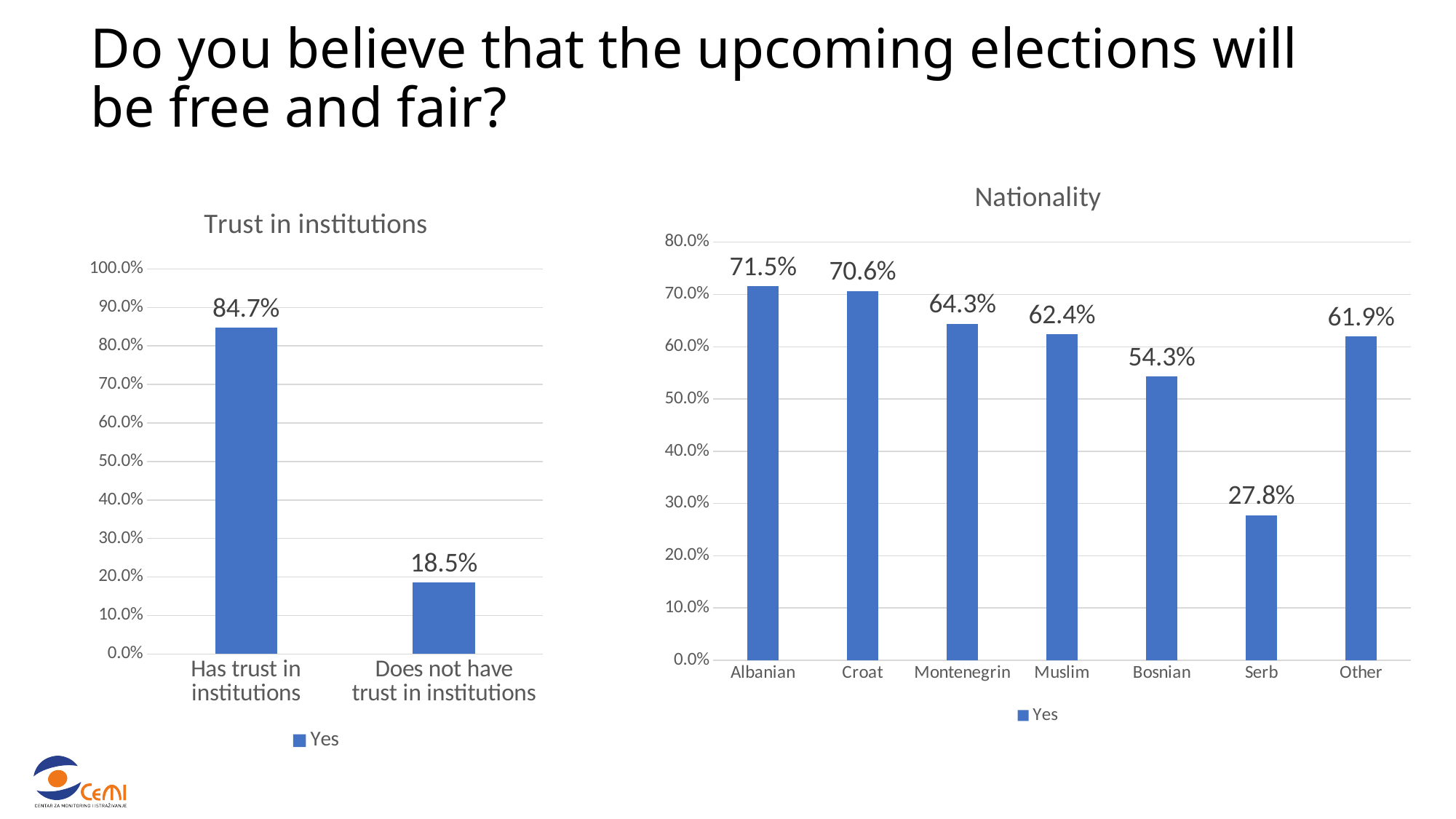
In the 'Trust in institutions' chart, what is the difference between the two bars? 66.2% In the 'Nationality' chart, which nationality has the lowest value? Serb In the 'Nationality' chart, which is larger, the value for Muslim or the value for Other? Muslim In the 'Nationality' chart, what is the value for Croat? 70.6% How many nationality categories are shown in the 'Nationality' chart? 7 In the 'Trust in institutions' chart, what is the value for 'Has trust in institutions'? 84.7% In the 'Nationality' chart, what is the difference between the values for Montenegrin and Bosnian? 10.0% In the 'Nationality' chart, which nationality has the highest value? Albanian In the 'Trust in institutions' chart, what is the value for 'Does not have trust in institutions'? 18.5% In the 'Nationality' chart, what is the value for Serb? 27.8% What kind of chart is the 'Nationality' chart? Bar chart How many series does the legend of the 'Trust in institutions' chart list? 1